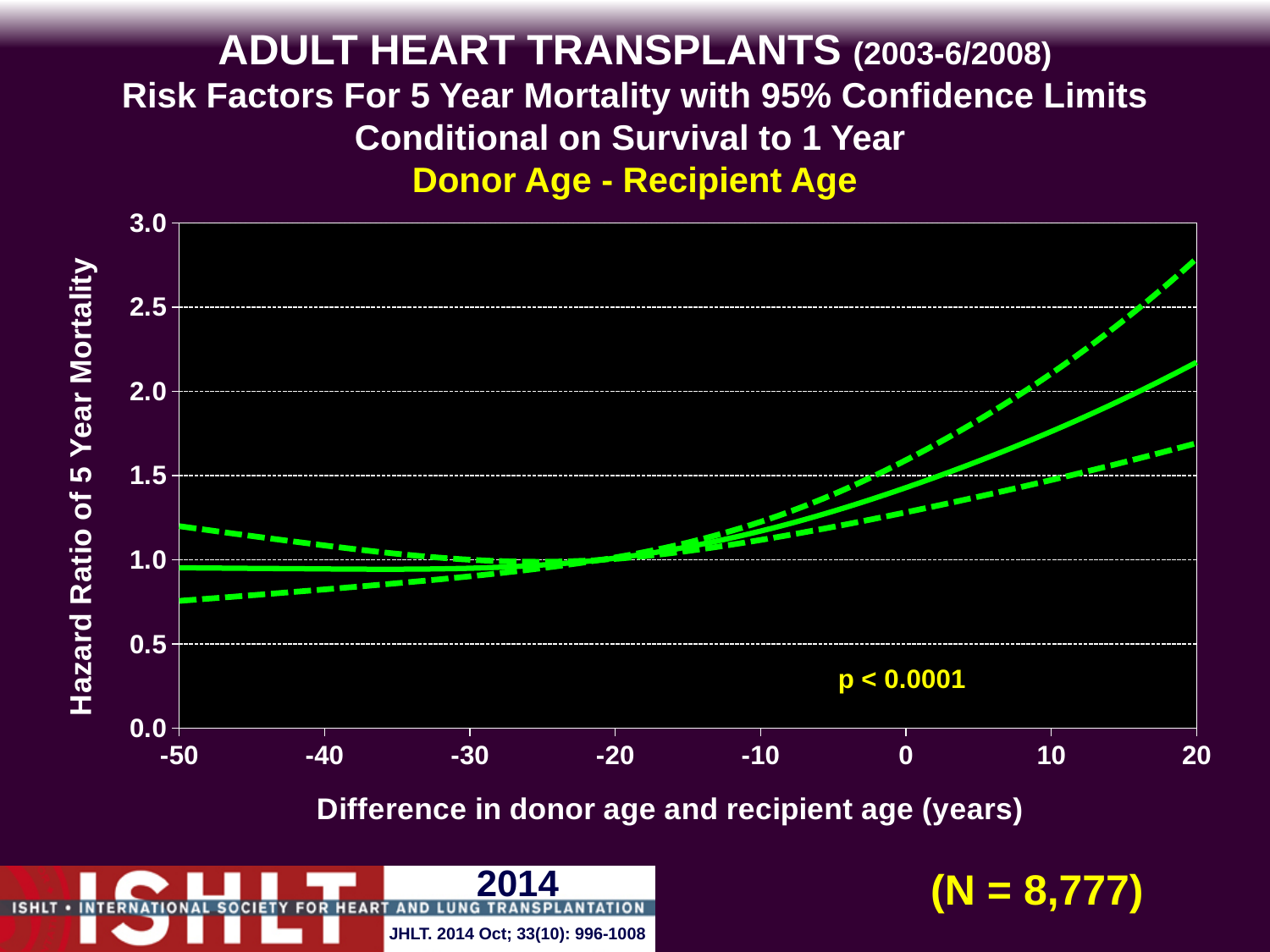
Is the hazard ratio (solid line) at a donor-recipient age difference of 20 years greater or less than 2.0? greater Is the hazard ratio (solid line) at a donor-recipient age difference of -50 years greater or less than 1.0? less Does the solid hazard ratio line rise or fall as the difference in donor age and recipient age increases from -20 to 20 years? rise How many lines are plotted on the chart? 3 Is the upper 95% confidence limit (upper dashed line) at a donor-recipient age difference of 20 years greater or less than 2.5? greater What kind of chart is shown on the slide? line chart What is the label of the y axis? Hazard Ratio of 5 Year Mortality What p-value is printed on the chart? p < 0.0001